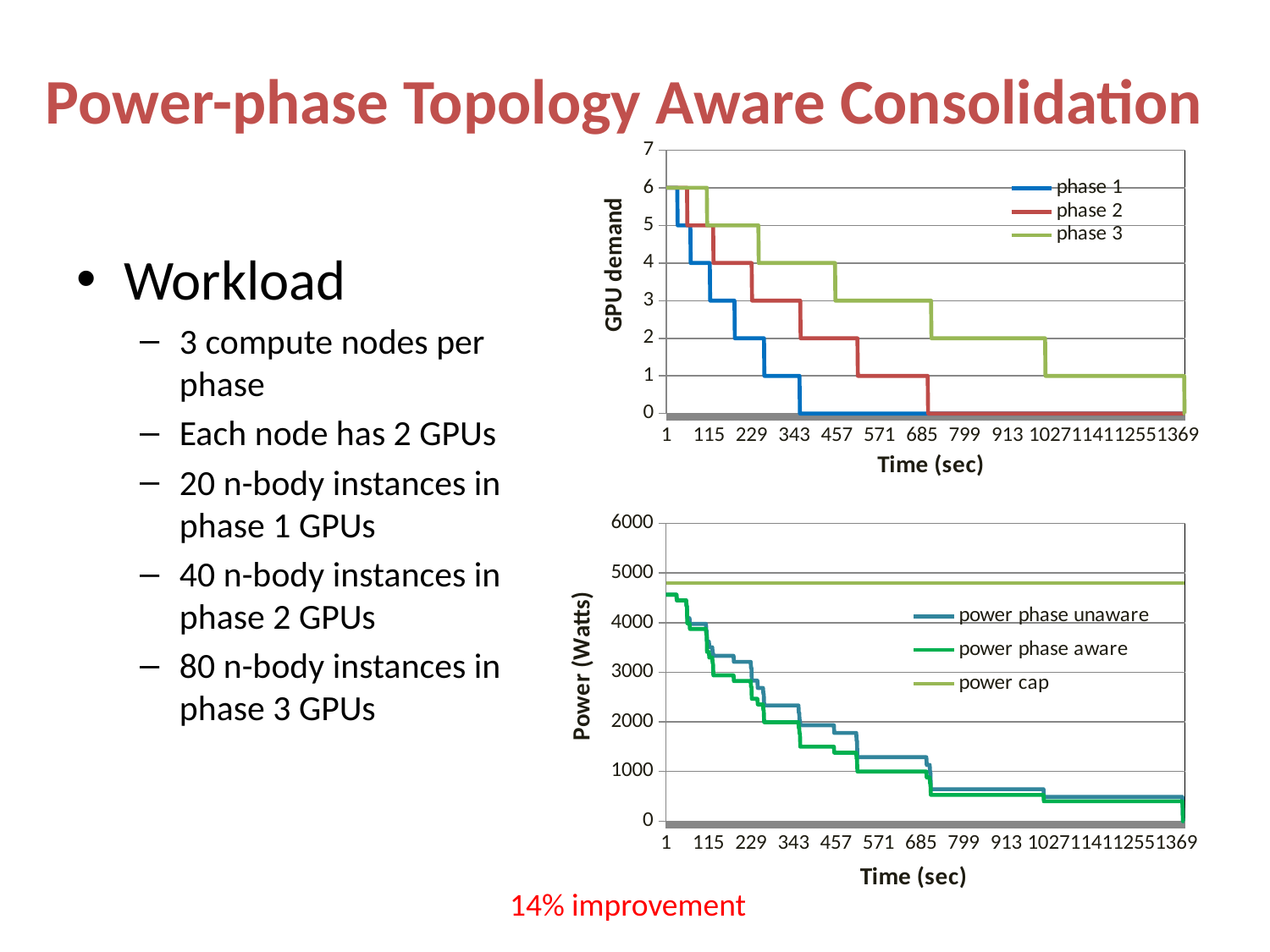
What is the y-axis label of the bottom chart? Power (Watts) In the bottom chart (Power), at time 343, which is larger, power phase unaware or power phase aware? power phase unaware How many series does the legend of the top chart (GPU demand) list? 3 What kind of chart is the top chart showing GPU demand? line chart In the top chart (GPU demand), what is the GPU demand of phase 1 at the start (time 1)? 6 In the top chart (GPU demand), does the GPU demand for phase 3 rise or fall as time increases? fall In the bottom chart (Power), is the power phase aware value at the start (time 1) greater or less than 4000? greater How many series does the legend of the bottom chart (Power) list? 3 In the top chart (GPU demand), which phase reaches a GPU demand of 0 first? phase 1 In the top chart (GPU demand), at time 571, which has the higher GPU demand, phase 2 or phase 3? phase 3 In the top chart (GPU demand), which phase keeps a non-zero GPU demand for the longest time? phase 3 In the bottom chart (Power), is the power cap value greater or less than 4000? greater